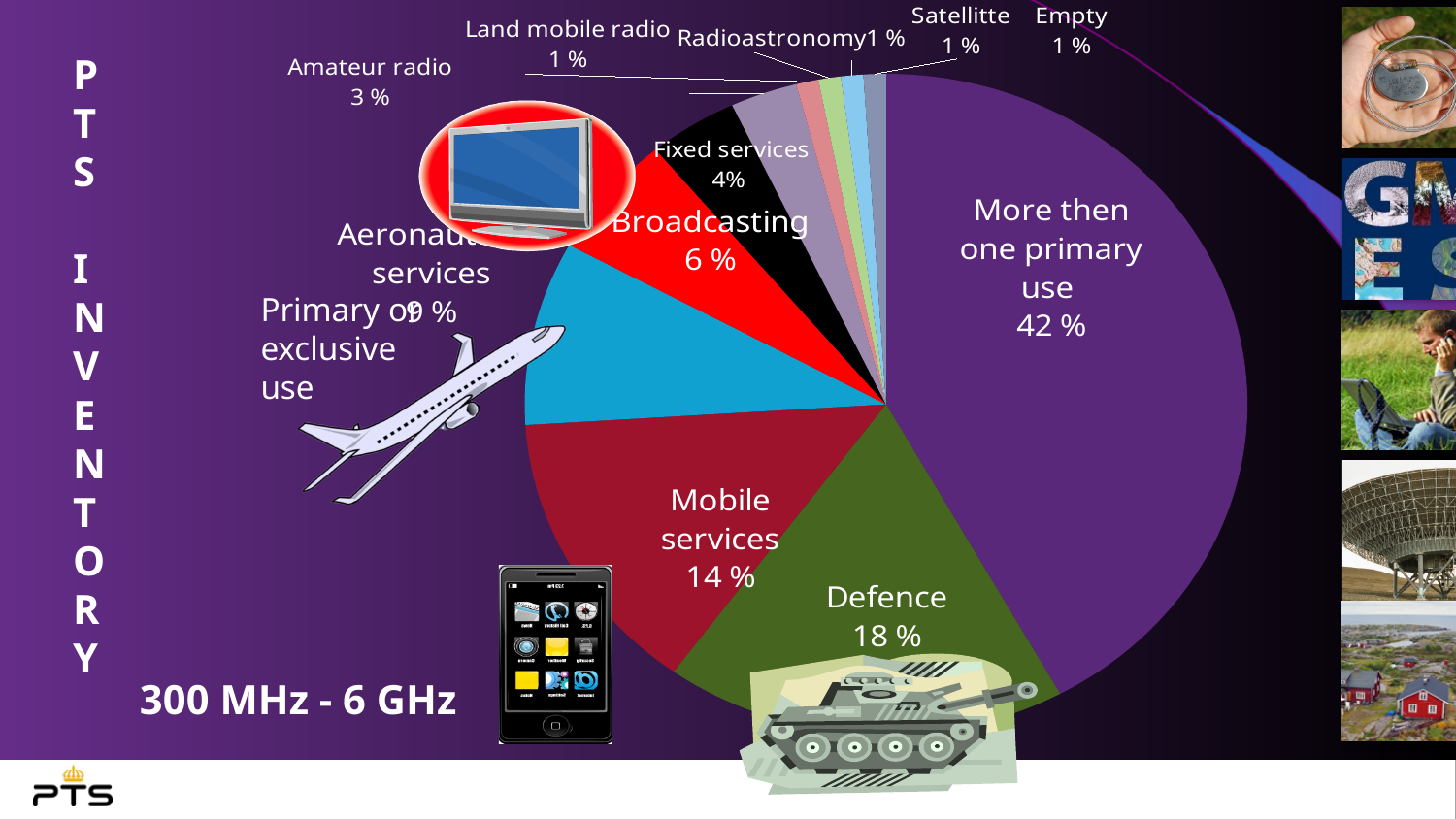
What percentage is shown for Fixed services? 4% What kind of chart is shown on the slide? pie chart What percentage is shown for Amateur radio? 3 % Which is larger, Defence or Mobile services? Defence What percentage is shown for Broadcasting? 6 % What share of the pie does Defence have? 18 % What percentage is shown for 'More then one primary use'? 42 % What is the difference in percentage points between Defence and Mobile services? 4 What frequency range is stated on the slide for the chart? 300 MHz - 6 GHz What percentage is shown for Mobile services? 14 % How many slices does the pie chart have? 11 Which category has the largest slice of the pie? More then one primary use